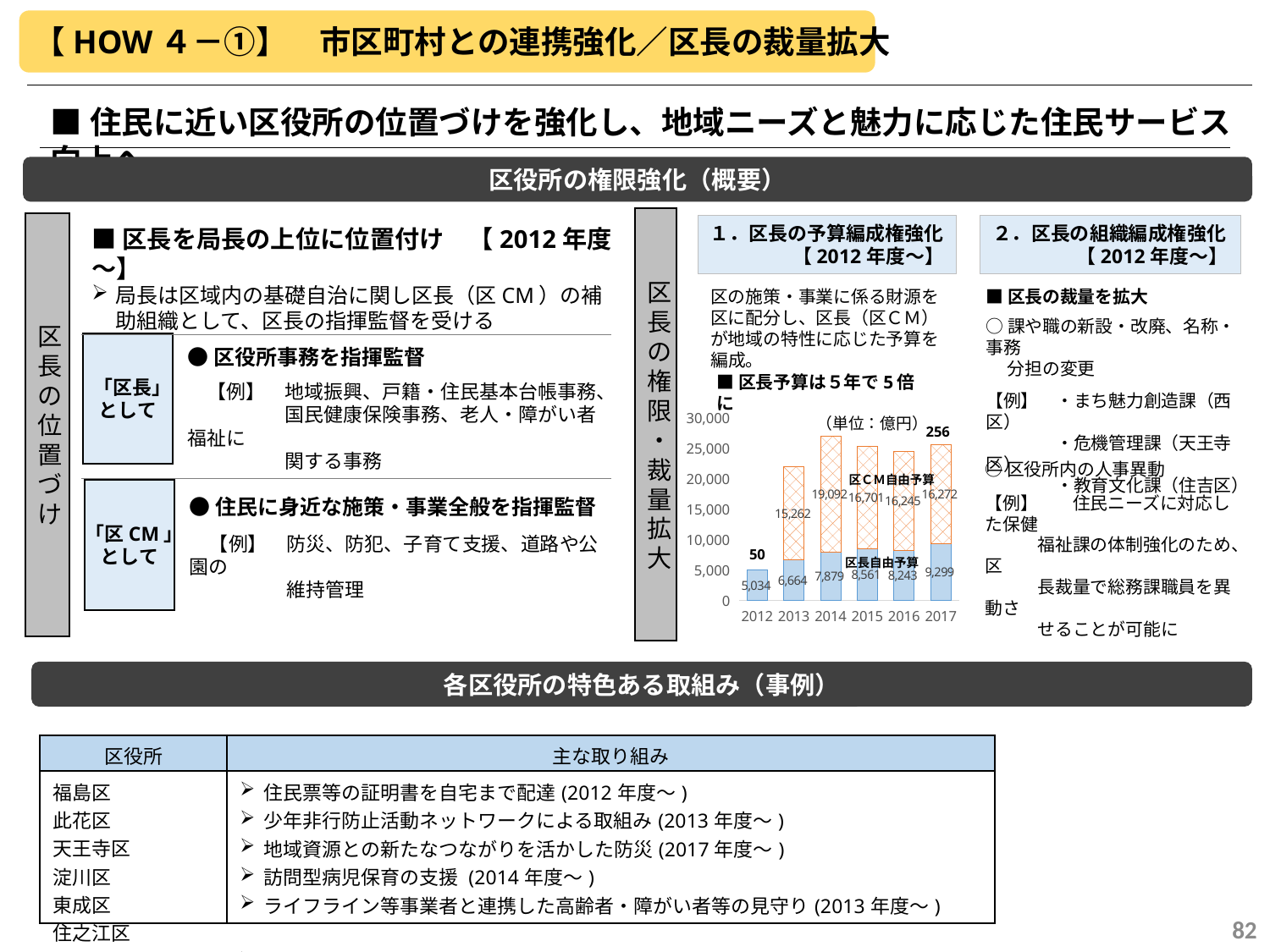
Which is larger, 区長自由予算 in 2015 or in 2016? 2015 What is the difference between 区長自由予算 in 2017 and in 2012? 4,265 How many years are shown on the x axis of the chart? 6 In which year is 区長自由予算 lowest? 2012 What kind of chart is used to show the 区長予算 data? Stacked bar chart What is the value of 区長自由予算 for 2017 in the chart? 9,299 In which year is 区長自由予算 highest? 2017 In which year is 区CM自由予算 highest? 2014 What is the value of 区長自由予算 for 2012 in the chart? 5,034 What is the value of 区CM自由予算 for 2014 in the chart? 19,092 What is the value of 区CM自由予算 for 2013 in the chart? 15,262 What unit is stated for the values in the chart? 億円